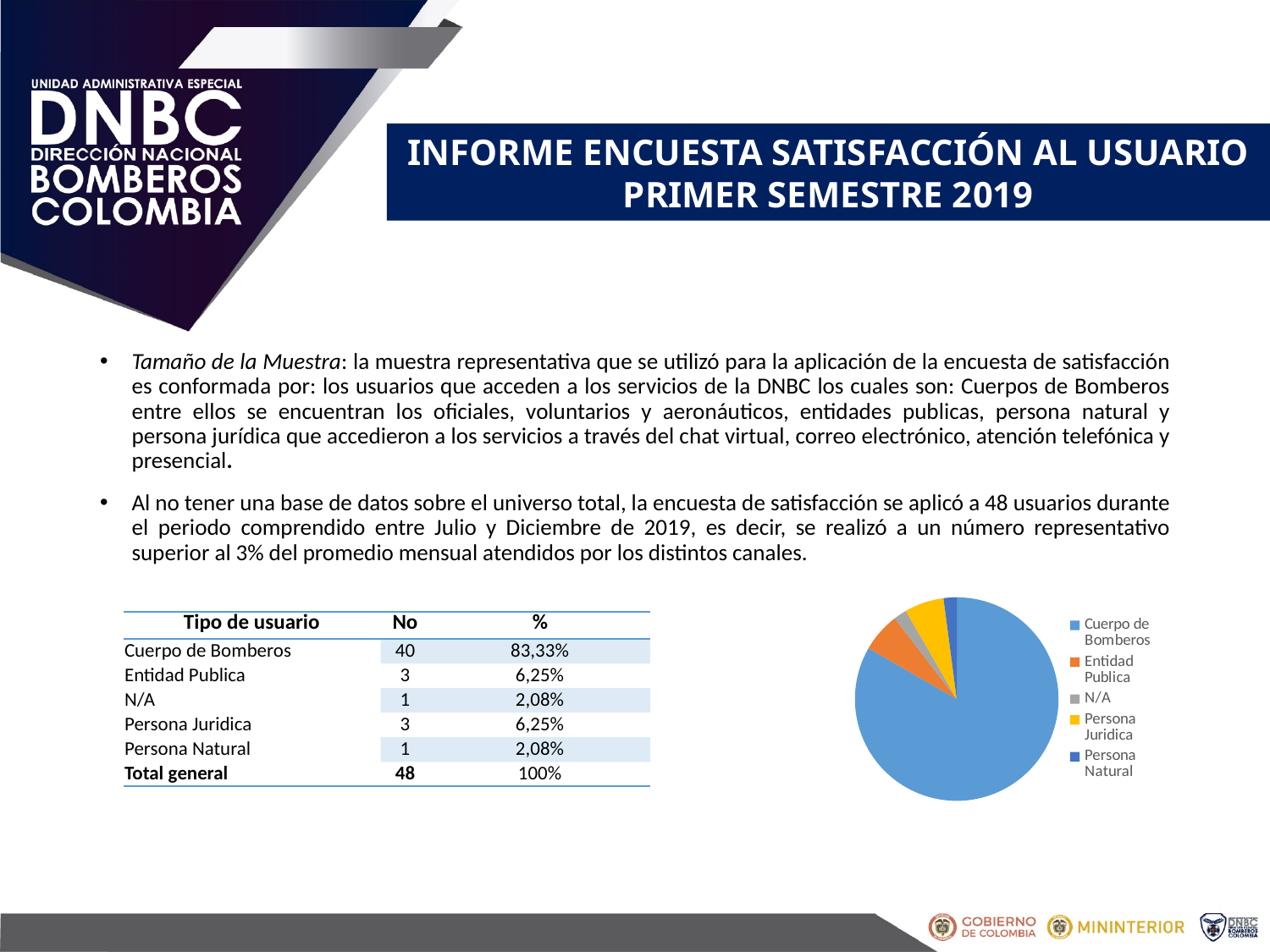
Which category has the largest slice in the pie chart? Cuerpo de Bomberos In the pie chart, which slice is larger: Entidad Publica or N/A? Entidad Publica According to the table next to the pie chart, what share of users is Entidad Publica? 6,25% How many categories does the pie chart's legend list? 5 According to the table next to the pie chart, how many users are Persona Juridica? 3 According to the table next to the pie chart, what is the total number of users surveyed? 48 In the pie chart, which slice is larger: Cuerpo de Bomberos or Entidad Publica? Cuerpo de Bomberos Which legend entry in the pie chart is shown in orange? Entidad Publica According to the table next to the pie chart, what share of users is Cuerpo de Bomberos? 83,33% What kind of chart is shown on the slide? pie chart In the pie chart, which slice is larger: Persona Juridica or Persona Natural? Persona Juridica What colour is the Cuerpo de Bomberos slice in the pie chart? blue